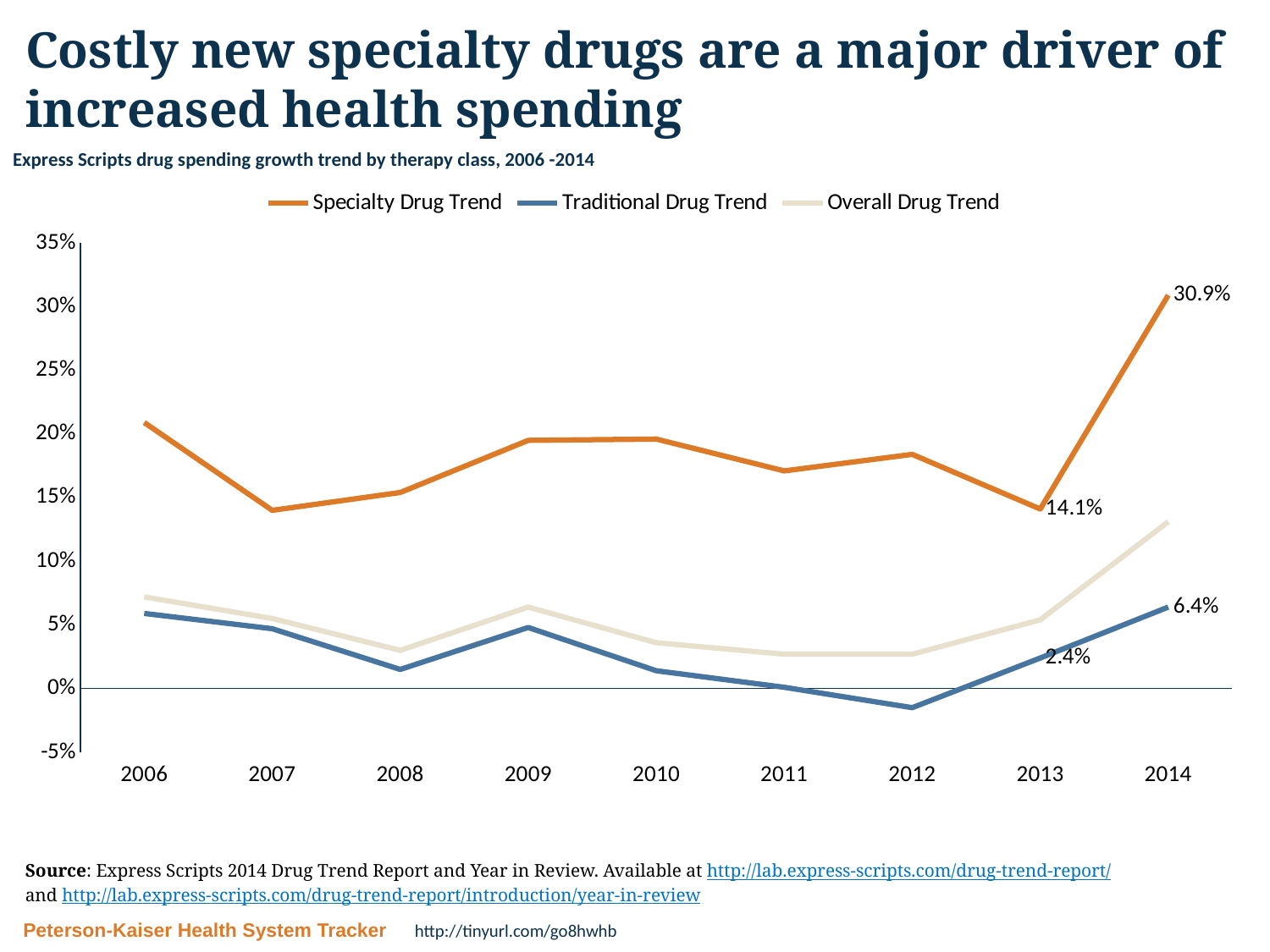
What is the Specialty Drug Trend value for 2014? 30.9% How many years are shown on the x axis? 9 In which year is the Traditional Drug Trend at its lowest? 2012 What is the Traditional Drug Trend value for 2014? 6.4% What kind of chart is shown on the slide? Line chart Is the Overall Drug Trend value for 2014 greater or less than 10%? greater What is the difference between the Specialty Drug Trend and the Traditional Drug Trend in 2014? 24.5 percentage points By how many percentage points did the Specialty Drug Trend increase from 2013 to 2014? 16.8 percentage points How many series does the legend list? 3 What is the Specialty Drug Trend value for 2013? 14.1% What is the Traditional Drug Trend value for 2013? 2.4% In which year is the Specialty Drug Trend at its highest? 2014